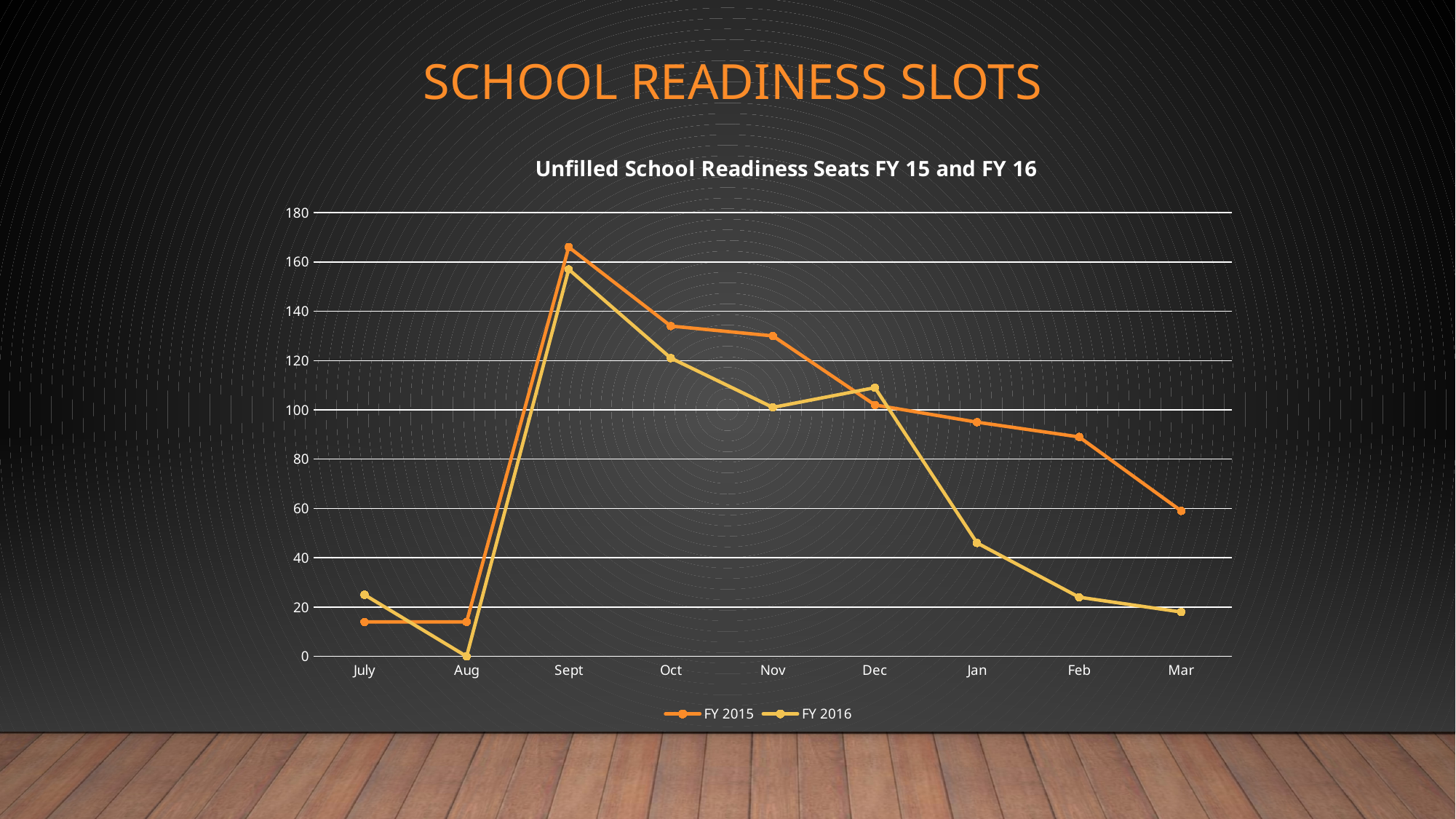
Is the FY 2016 value for Jan greater or less than 60? less How many months are shown on the x axis? 9 Is the FY 2015 value for Oct greater or less than 120? greater In which month does the FY 2015 series reach its highest value? Sept Is the FY 2015 value for Sept greater or less than 160? greater What is the title of the chart? Unfilled School Readiness Seats FY 15 and FY 16 In Jan, which series has the larger value, FY 2015 or FY 2016? FY 2015 In which month does the FY 2016 series reach its lowest value? Aug In July, which series has the larger value, FY 2015 or FY 2016? FY 2016 How many series does the legend list? 2 What type of chart is shown on the slide? line chart What is the FY 2016 value for Aug? 0